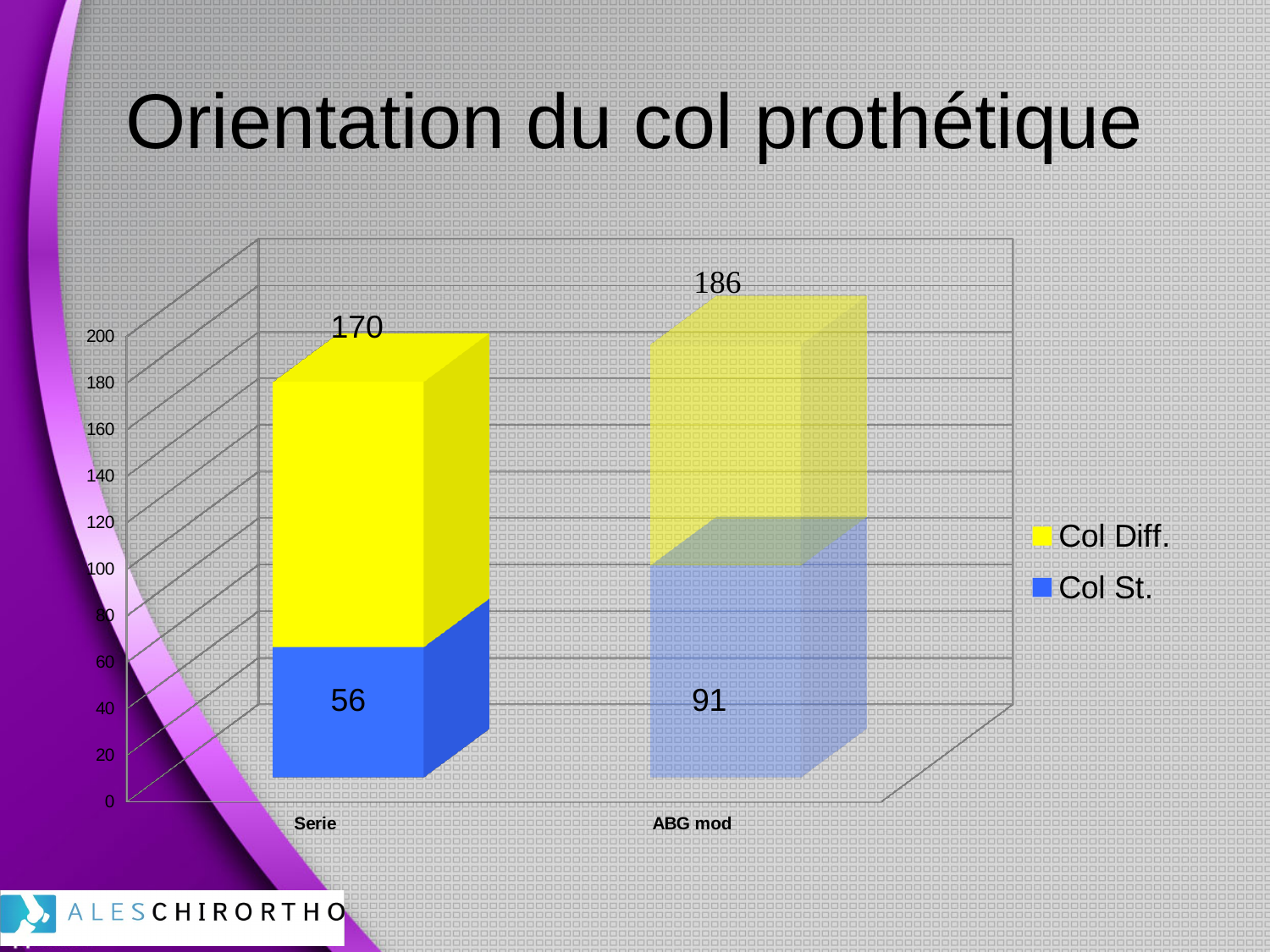
How many series does the legend list? 2 How many categories are shown on the x axis? 2 What value is printed at the top of the Serie bar? 170 What value is printed inside the Col St. segment of the ABG mod bar? 91 Which colour represents the Col Diff. series in the legend? Yellow What is the difference between the Col St. values of ABG mod and Serie? 35 What value is printed inside the Col St. segment of the Serie bar? 56 What is the difference between the values printed at the top of the ABG mod bar and the Serie bar? 16 Which category has the taller stacked bar overall? ABG mod Which category has the larger Col St. value, Serie or ABG mod? ABG mod What kind of chart is shown on the slide? Stacked bar chart What value is printed at the top of the ABG mod bar? 186